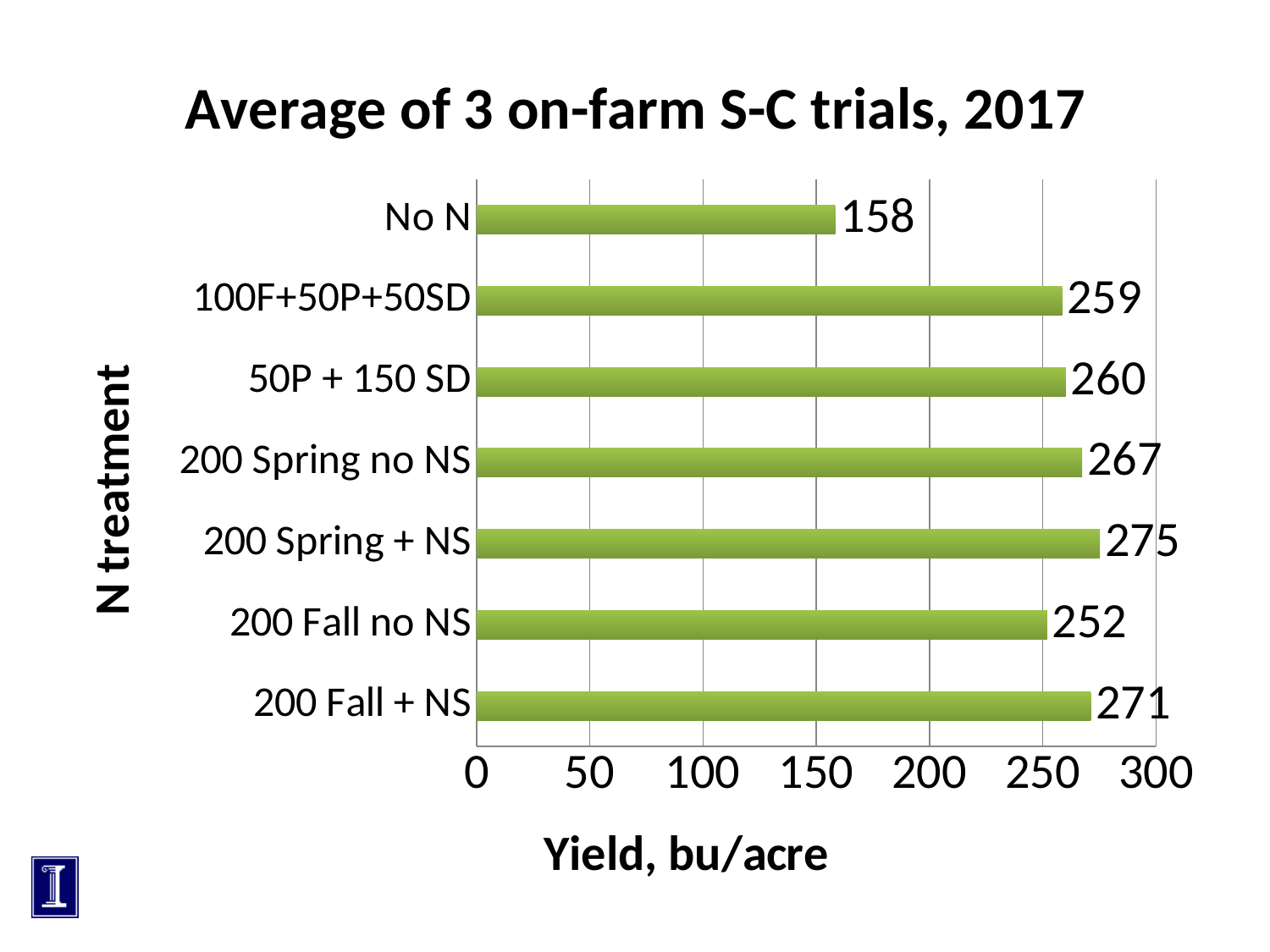
What is the difference in yield between 200 Fall + NS and 200 Fall no NS? 19 Which N treatment has the lowest yield? No N What is the title of the chart? Average of 3 on-farm S-C trials, 2017 What is the difference in yield between 200 Spring + NS and No N? 117 What kind of chart is shown on the slide? Bar chart What is the yield for the No N treatment? 158 How many N treatments are shown in the chart? 7 What is the yield for the 200 Fall no NS treatment? 252 What is the yield for the 200 Spring + NS treatment? 275 What is the yield for the 50P + 150 SD treatment? 260 Which has a higher yield, 200 Spring no NS or 100F+50P+50SD? 200 Spring no NS Which N treatment has the highest yield? 200 Spring + NS